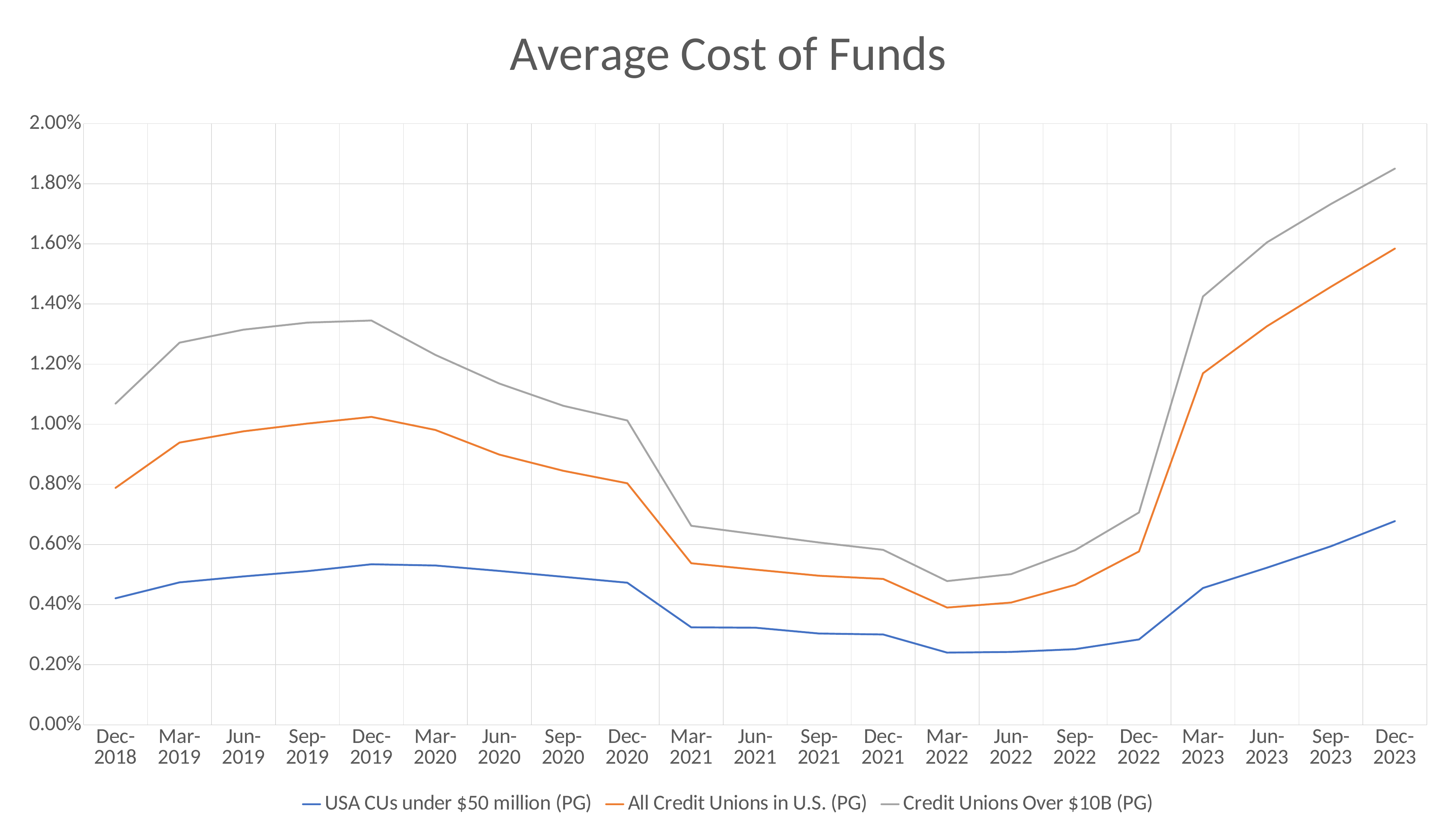
At Dec-2018, which is larger: Credit Unions Over $10B (PG) or USA CUs under $50 million (PG)? Credit Unions Over $10B (PG) Which series is drawn in orange? All Credit Unions in U.S. (PG) Is the value for All Credit Unions in U.S. (PG) at Dec-2023 greater or less than 1.40%? greater At which time point does Credit Unions Over $10B (PG) reach its highest value? Dec-2023 Is the value for Credit Unions Over $10B (PG) at Dec-2019 greater or less than 1.20%? greater What is the title of the chart? Average Cost of Funds How many series does the legend list? 3 How many time points are shown on the x axis? 21 Do the values for All Credit Unions in U.S. (PG) rise or fall from Dec-2022 to Dec-2023? rise Is the value for USA CUs under $50 million (PG) at Mar-2022 greater or less than 0.40%? less What type of chart is shown on the slide? line chart